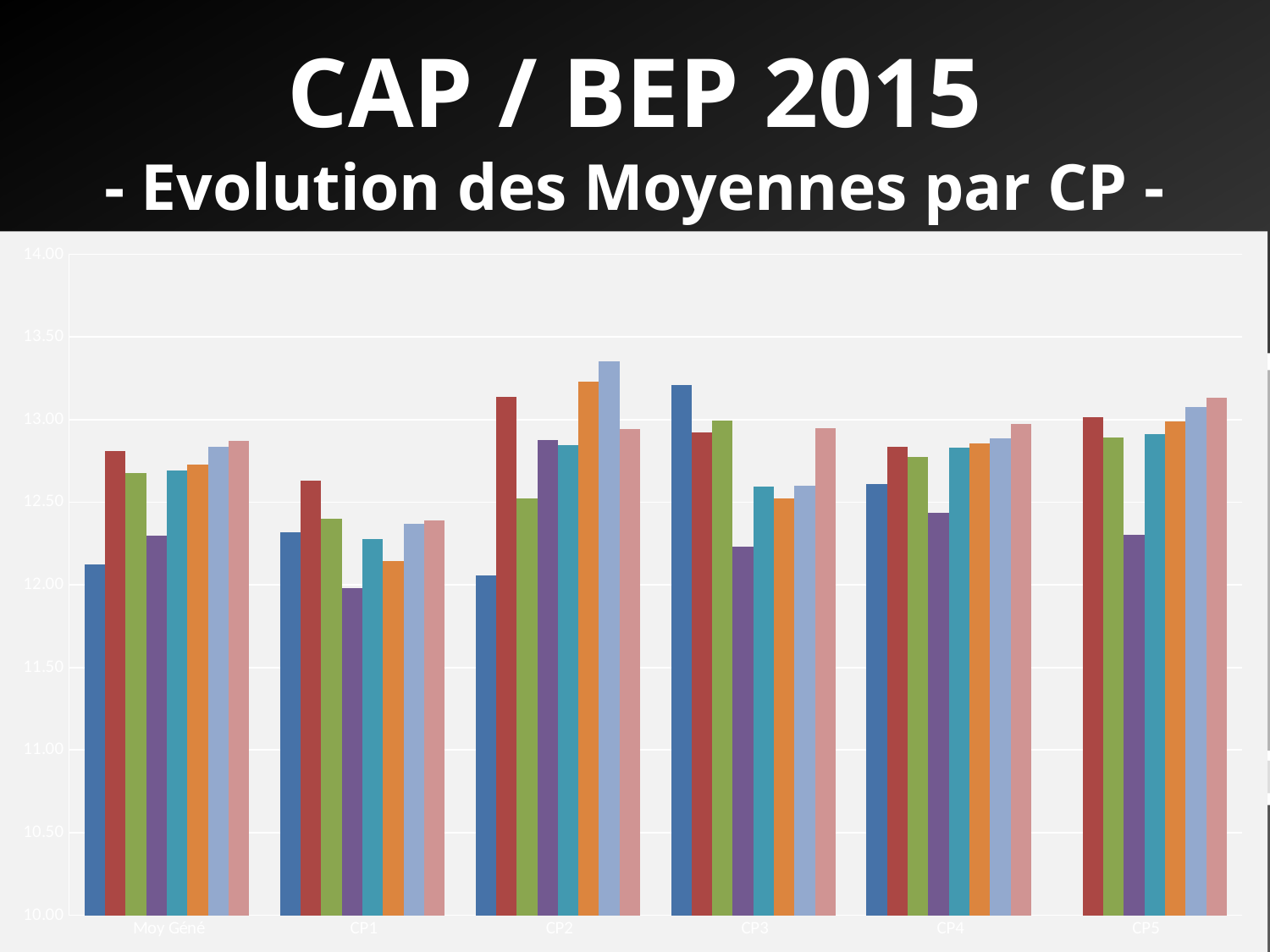
Which is larger: the dark blue bar for CP3 or the dark blue bar for CP2? CP3 How many categories are shown along the x axis of the chart? 6 Which category contains the shortest bar in the whole chart? CP1 Which category contains the tallest bar in the whole chart? CP2 What is the label of the first category on the x axis? Moy Géné What kind of chart is shown on the slide? bar chart Is the value of the dark blue bar for CP3 greater or less than 13.00? greater Is the value of the light blue bar for CP2 greater or less than 13.00? greater Is the value of the dark blue bar for CP2 greater or less than 12.50? less What is the highest value shown on the vertical axis of the chart? 14.00